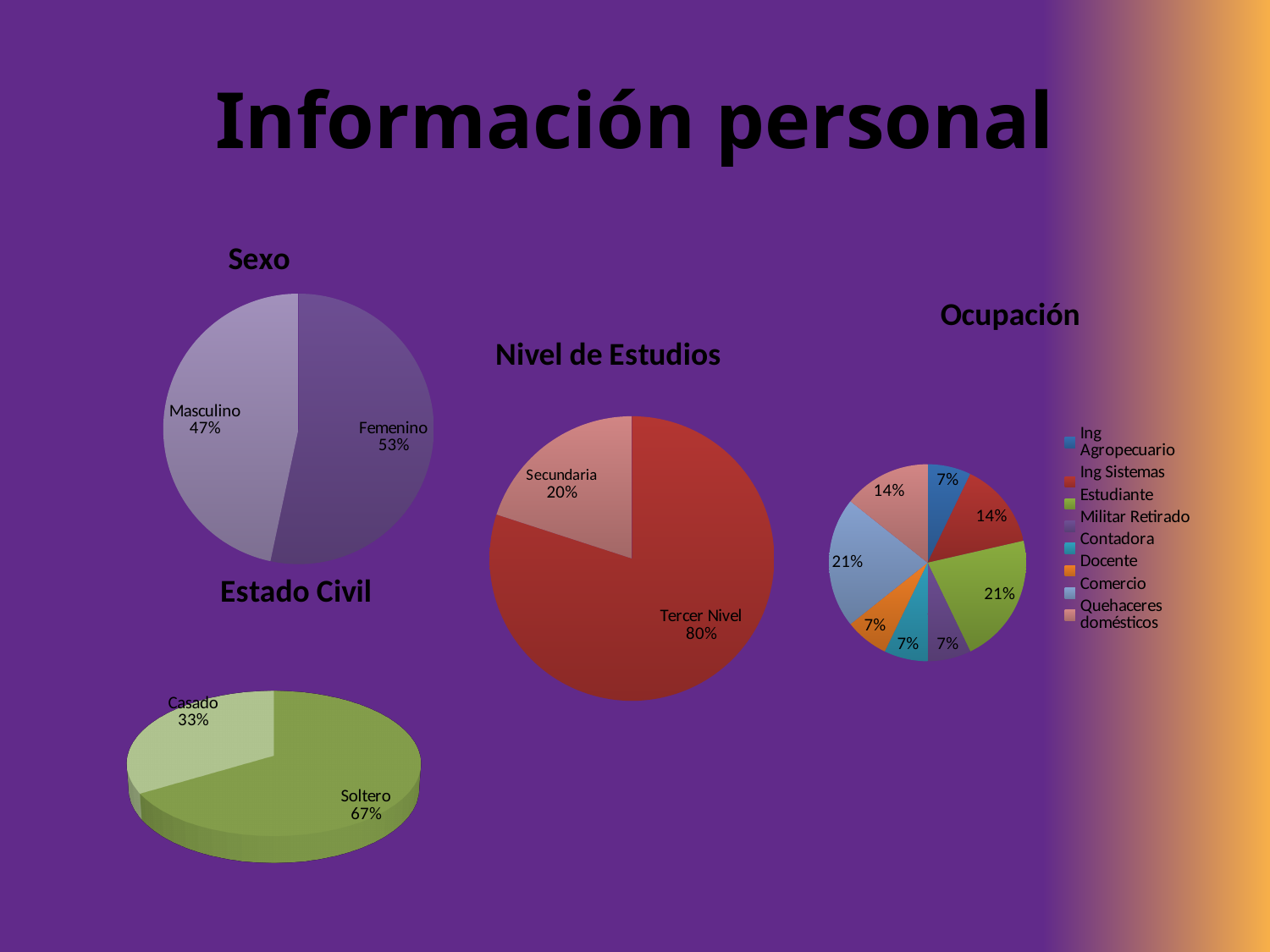
In the Sexo chart, what share is Femenino? 53% In the Estado Civil chart, which category has the smallest share? Casado In the Nivel de Estudios chart, what share is Tercer Nivel? 80% In the Ocupación chart, what share is Estudiante? 21% How many pie charts are shown on the slide? 4 How many entries does the legend of the Ocupación chart list? 8 In the Nivel de Estudios chart, what is the difference between the Tercer Nivel and Secundaria shares? 60% In the Sexo chart, which category has the larger share, Masculino or Femenino? Femenino What kind of chart is the Estado Civil chart? Pie chart